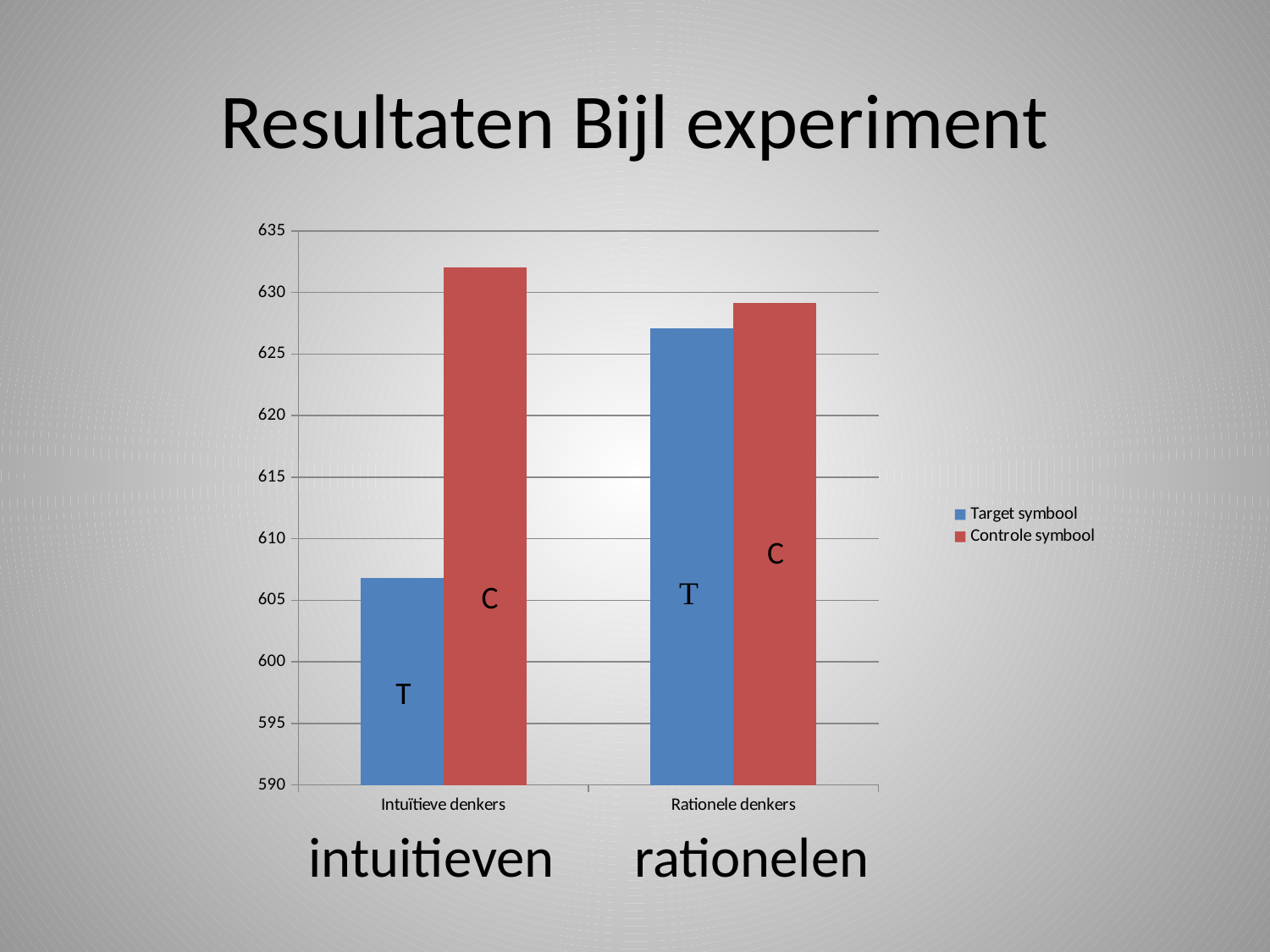
How many categories are shown on the x axis? 2 What is the title of the slide containing the chart? Resultaten Bijl experiment Does the Controle symbool series rise or fall from Intuïtieve denkers to Rationele denkers? fall Which bar is the lowest in the chart? Target symbool for Intuïtieve denkers How many series does the legend list? 2 Is the Target symbool value for Intuïtieve denkers greater or less than 610? less For the Target symbool series, which category has the larger value: Intuïtieve denkers or Rationele denkers? Rationele denkers What kind of chart is shown on the slide? bar chart Which bar is the highest in the chart? Controle symbool for Intuïtieve denkers Which colour represents the Controle symbool series? red For Intuïtieve denkers, which is larger: Target symbool or Controle symbool? Controle symbool Is the Controle symbool value for Intuïtieve denkers greater or less than 625? greater